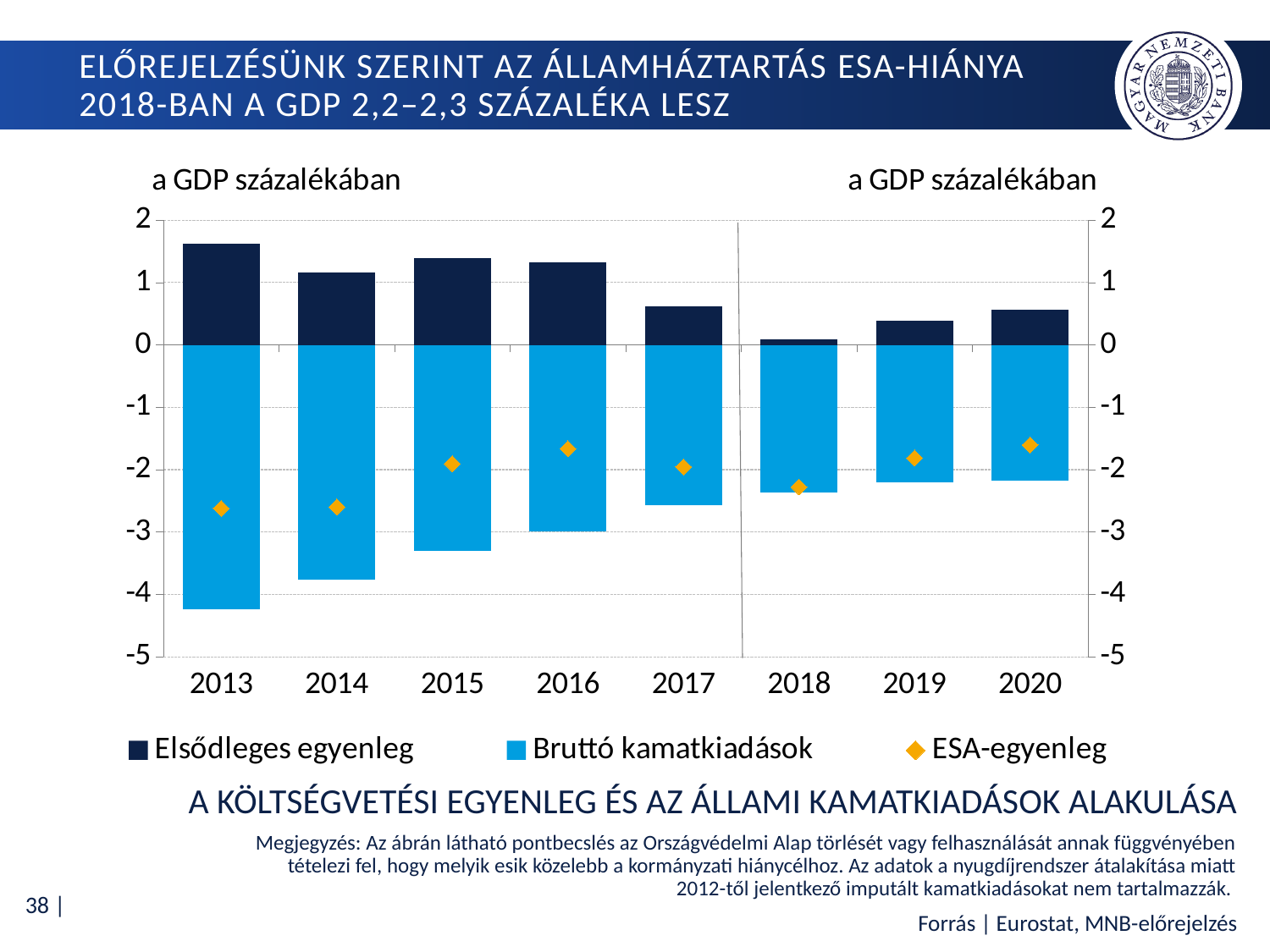
Is the ESA-egyenleg value for 2018 greater or less than -2? less In which year is the Elsődleges egyenleg bar the highest? 2013 What kind of chart is shown on the slide? bar chart Which is larger, the Elsődleges egyenleg value for 2013 or for 2017? 2013 In which year is the Elsődleges egyenleg bar the lowest? 2018 Which series is shown with diamond markers? ESA-egyenleg Is the Elsődleges egyenleg value for 2013 greater or less than 1? greater What is the title of the chart? A KÖLTSÉGVETÉSI EGYENLEG ÉS AZ ÁLLAMI KAMATKIADÁSOK ALAKULÁSA Do the Bruttó kamatkiadások values rise or fall from 2013 to 2020? rise How many series does the legend list? 3 How many years are shown on the x axis of the chart? 8 Is the Bruttó kamatkiadások value for 2013 greater or less than -4? less